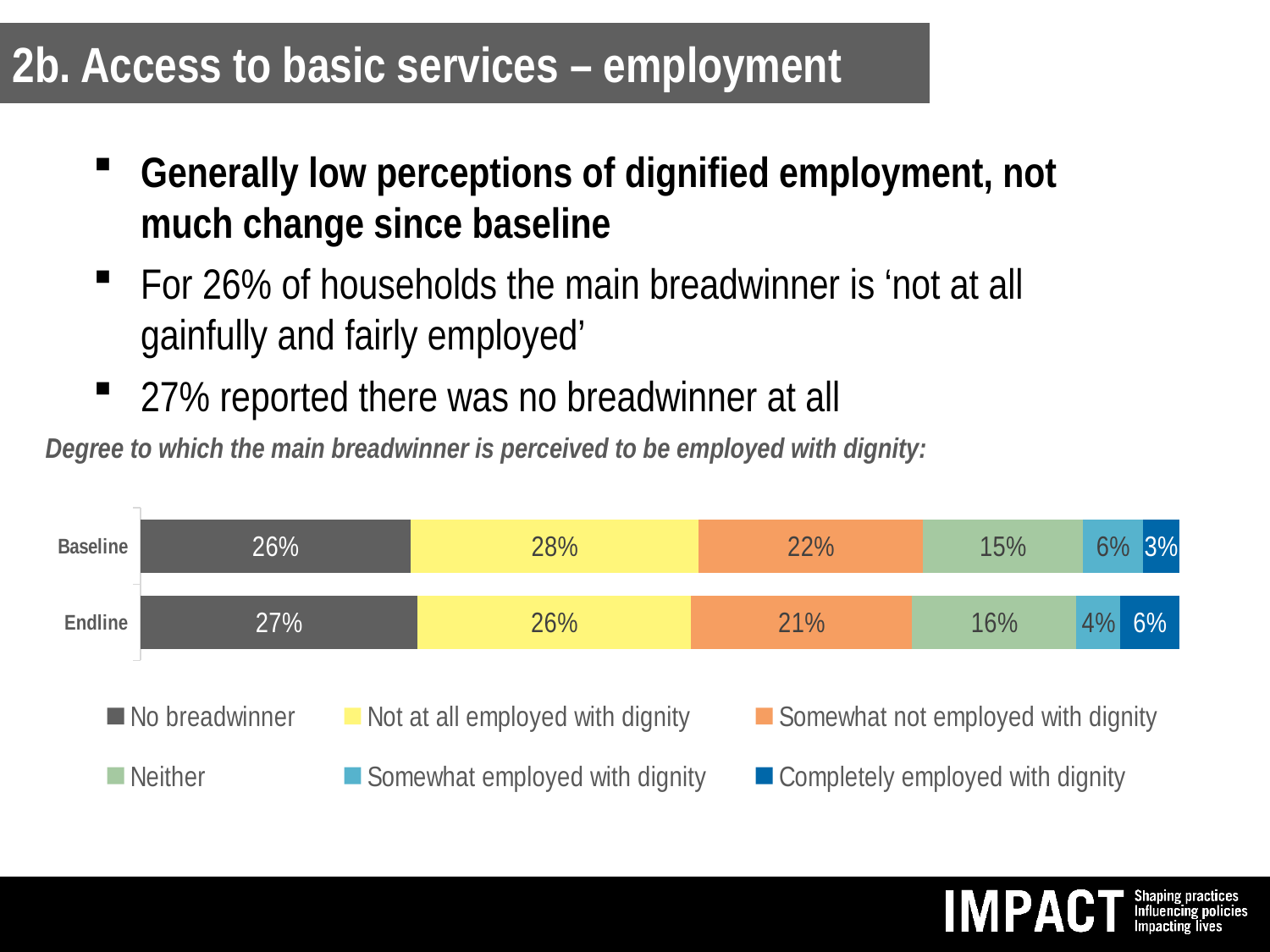
What is the difference between the 'Somewhat not employed with dignity' values for Baseline and Endline? 1% What is the value for 'Completely employed with dignity' in the Endline bar? 6% Which segment is the smallest in the Endline bar? Somewhat employed with dignity What is the total of the Endline stacked bar? 100% Which is larger: the 'Neither' value for Baseline or for Endline? Endline What is the value for 'Not at all employed with dignity' in the Baseline bar? 28% What is the value for 'Somewhat employed with dignity' in the Baseline bar? 6% How many categories (bars) are plotted on the chart? 2 How many series does the legend list? 6 What kind of chart is shown on the slide? Stacked bar chart What is the value for 'No breadwinner' in the Endline bar? 27% Which segment is the largest in the Baseline bar? Not at all employed with dignity